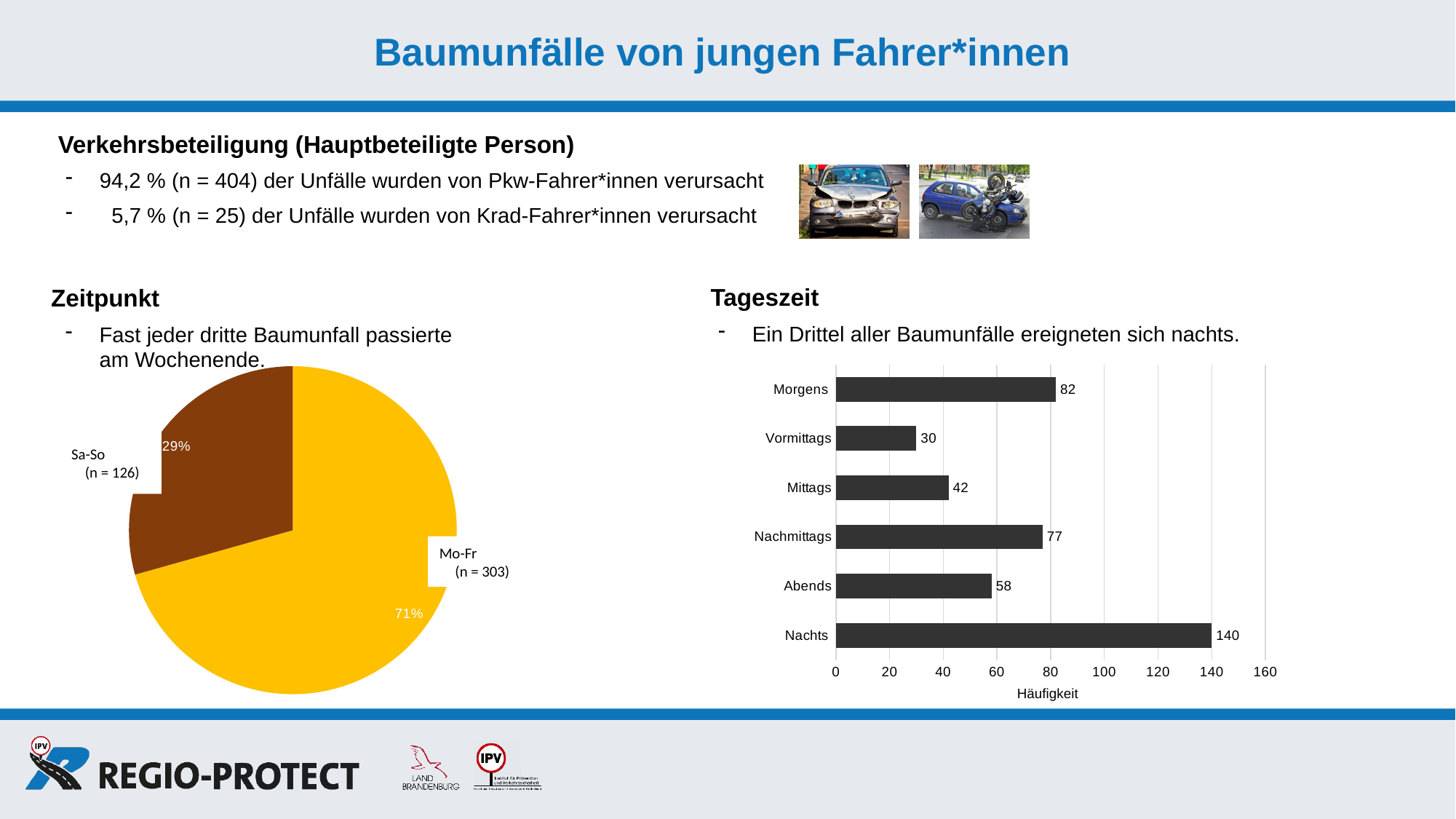
In the bar chart on the right (Tageszeit), what is the value for Nachts? 140 In the bar chart on the right (Tageszeit), how many categories are shown? 6 What kind of chart is shown on the left of the slide under Zeitpunkt? pie chart In the bar chart on the right (Tageszeit), what is the label of the horizontal axis? Häufigkeit In the bar chart on the right (Tageszeit), which is larger, the value for Nachmittags or the value for Abends? Nachmittags In the bar chart on the right (Tageszeit), which category has the highest value? Nachts What kind of chart is shown on the right of the slide under Tageszeit? bar chart In the pie chart on the left (Zeitpunkt), what share does the Sa-So slice have? 29% In the bar chart on the right (Tageszeit), what is the value for Vormittags? 30 In the pie chart on the left (Zeitpunkt), what is the n value shown for Mo-Fr? n = 303 In the bar chart on the right (Tageszeit), what is the difference between the values for Nachts and Morgens? 58 In the bar chart on the right (Tageszeit), which category has the lowest value? Vormittags